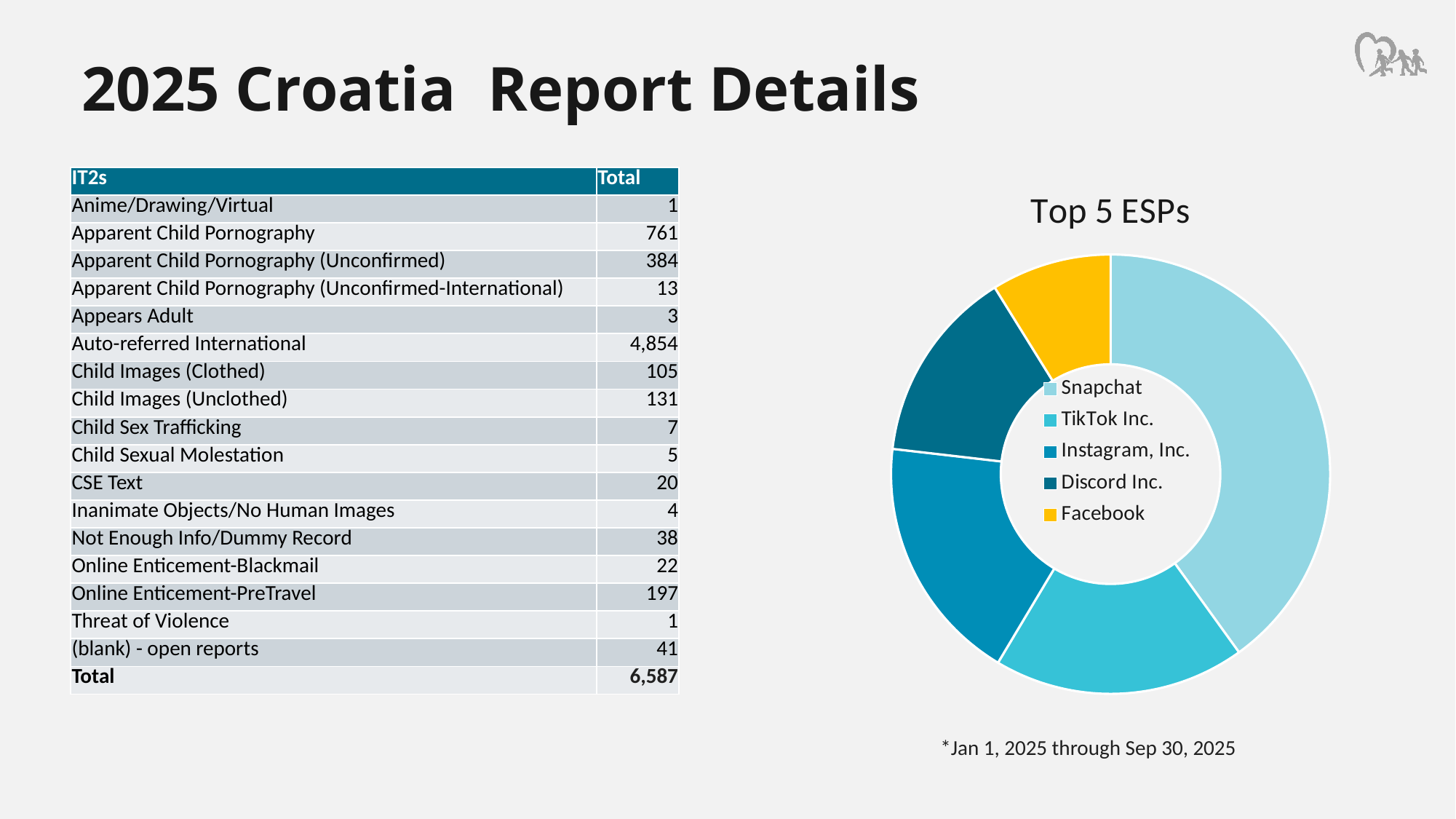
How many entries does the legend of the "Top 5 ESPs" chart list? 5 In the "Top 5 ESPs" chart, which ESP has the smallest slice? Facebook In the "Top 5 ESPs" chart, which slice is larger: Instagram, Inc. or Facebook? Instagram, Inc. Which ESP is represented by the yellow slice in the "Top 5 ESPs" chart? Facebook In the "Top 5 ESPs" chart, which slice is larger: Discord Inc. or Facebook? Discord Inc. In the "Top 5 ESPs" chart, which slice is larger: Snapchat or TikTok Inc.? Snapchat How many ESPs are shown as slices in the "Top 5 ESPs" chart? 5 What is the title of the doughnut chart on the slide? Top 5 ESPs In the "Top 5 ESPs" chart, which ESP has the largest slice? Snapchat What kind of chart is shown under the title "Top 5 ESPs"? Doughnut chart